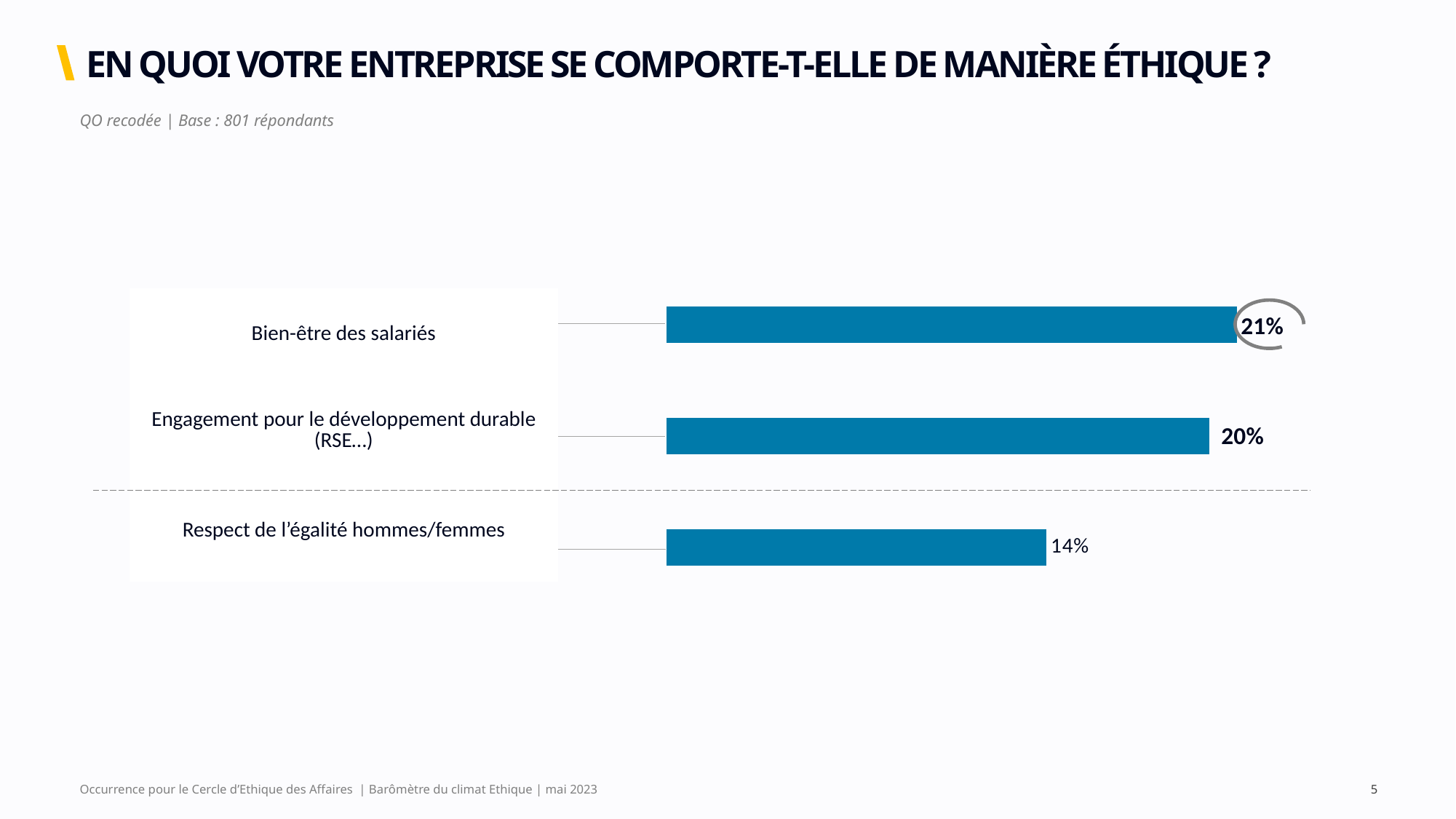
What is the value for "Engagement pour le développement durable (RSE…)"? 20% What is the value for "Respect de l'égalité hommes/femmes"? 14% What kind of chart is shown on the slide? Bar chart Which category has the lowest value? Respect de l'égalité hommes/femmes What is the difference between the values for "Engagement pour le développement durable (RSE…)" and "Respect de l'égalité hommes/femmes"? 6% Which category has the highest value? Bien-être des salariés How many respondents form the base of the chart, according to the subtitle? 801 What is the difference between the values for "Bien-être des salariés" and "Respect de l'égalité hommes/femmes"? 7% Which is larger: the value for "Engagement pour le développement durable (RSE…)" or the value for "Respect de l'égalité hommes/femmes"? Engagement pour le développement durable (RSE…) What is the value for "Bien-être des salariés"? 21% How many categories are shown in the chart? 3 Which value on the chart is circled? 21%